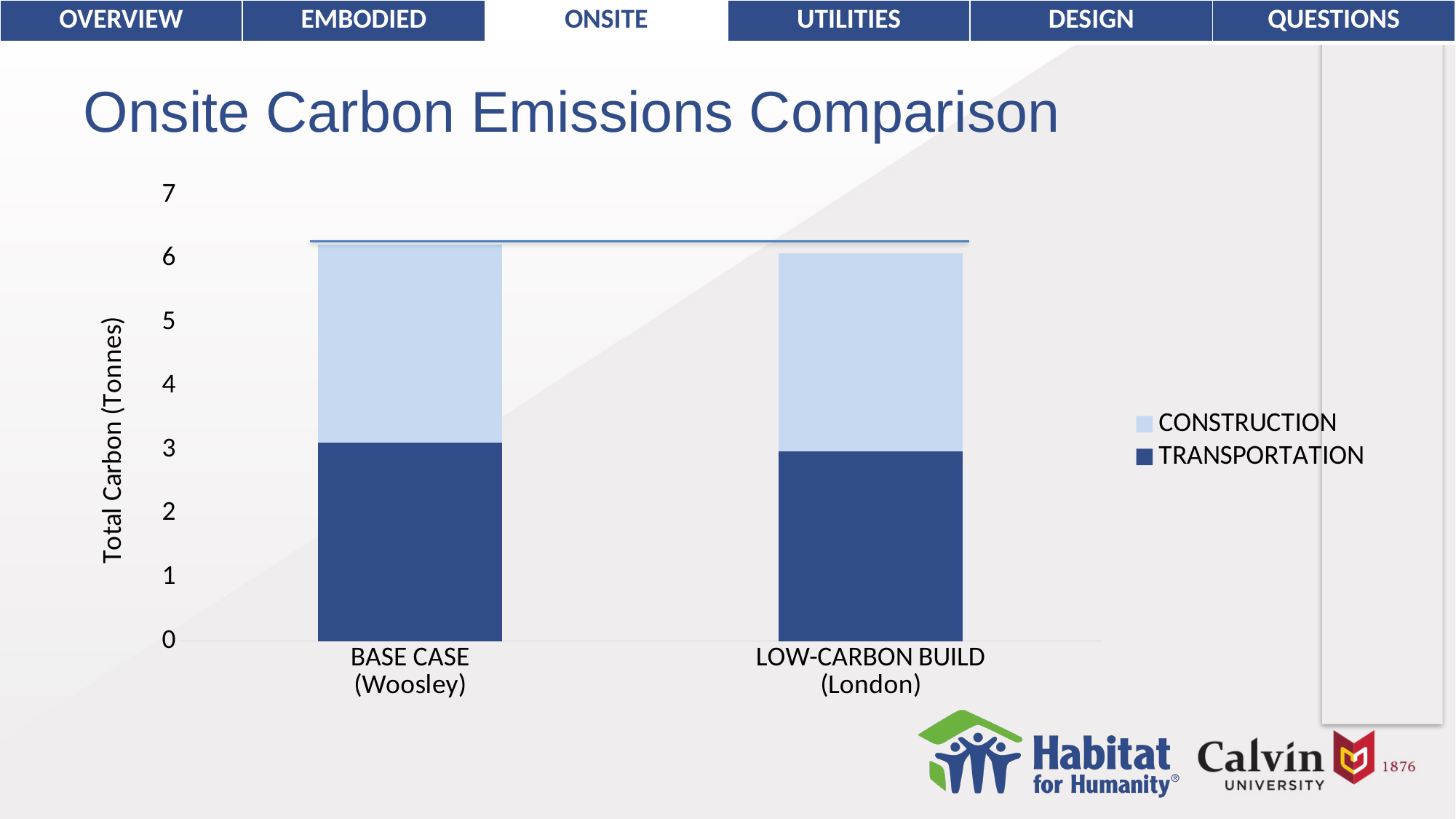
What are the two series listed in the chart's legend? CONSTRUCTION and TRANSPORTATION What is the label on the chart's vertical axis? Total Carbon (Tonnes) How many categories are shown on the x axis of the chart? 2 Is the TRANSPORTATION value for LOW-CARBON BUILD (London) greater or less than 4? less How many series does the chart's legend list? 2 What kind of chart is shown on the slide? Stacked bar chart Is the total height of the LOW-CARBON BUILD (London) bar greater or less than 7? less Is the total height of the LOW-CARBON BUILD (London) bar greater or less than 5? greater